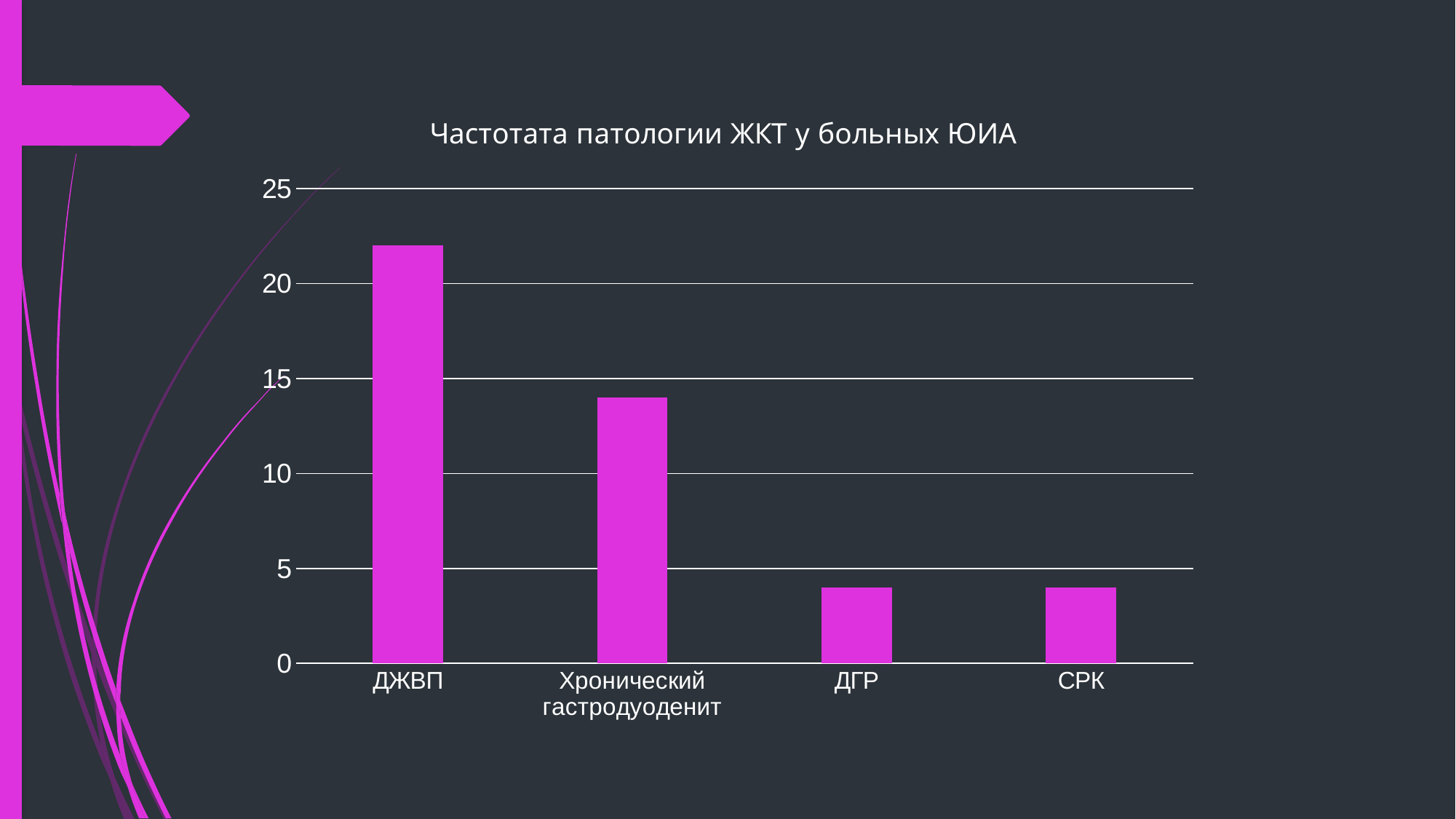
Which category has the highest value in the chart? ДЖВП Is the value for ДГР greater or less than 5? less What is the title of the chart? Частотата патологии ЖКТ у больных ЮИА Is the value for Хронический гастродуоденит greater or less than 10? greater Is the value for ДЖВП greater or less than 20? greater What kind of chart is shown on the slide? bar chart Which is larger, the value for ДЖВП or the value for Хронический гастродуоденит? ДЖВП Which is larger, the value for Хронический гастродуоденит or the value for ДГР? Хронический гастродуоденит Do the values generally rise or fall from left to right along the x axis? fall How many categories are shown on the x axis of the chart? 4